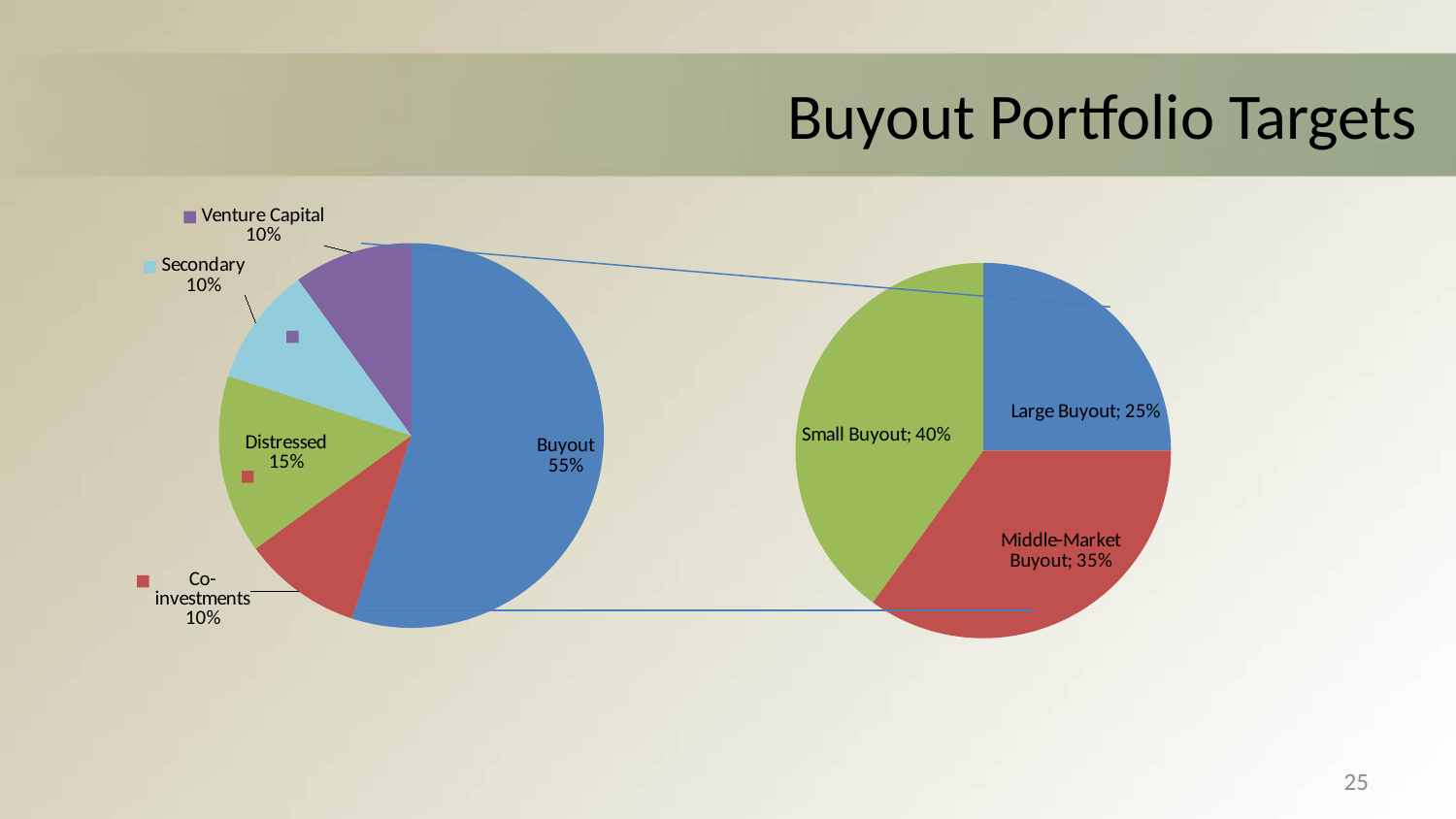
On the left pie chart, which is larger, Distressed or Secondary? Distressed On the left pie chart, what share does Distressed have? 15% On the right pie chart, what share does Large Buyout have? 25% What type of chart is shown on the slide? Pie chart On the right pie chart, what share does Small Buyout have? 40% On the left pie chart, what share does Buyout have? 55% What is the title of the slide? Buyout Portfolio Targets On the left pie chart, how many slices are there? 5 On the right pie chart, what is the difference between the Small Buyout share and the Middle-Market Buyout share? 5% On the left pie chart, what is the difference between the Buyout share and the Distressed share? 40% On the left pie chart, which category has the largest share? Buyout On the right pie chart, which category has the smallest share? Large Buyout